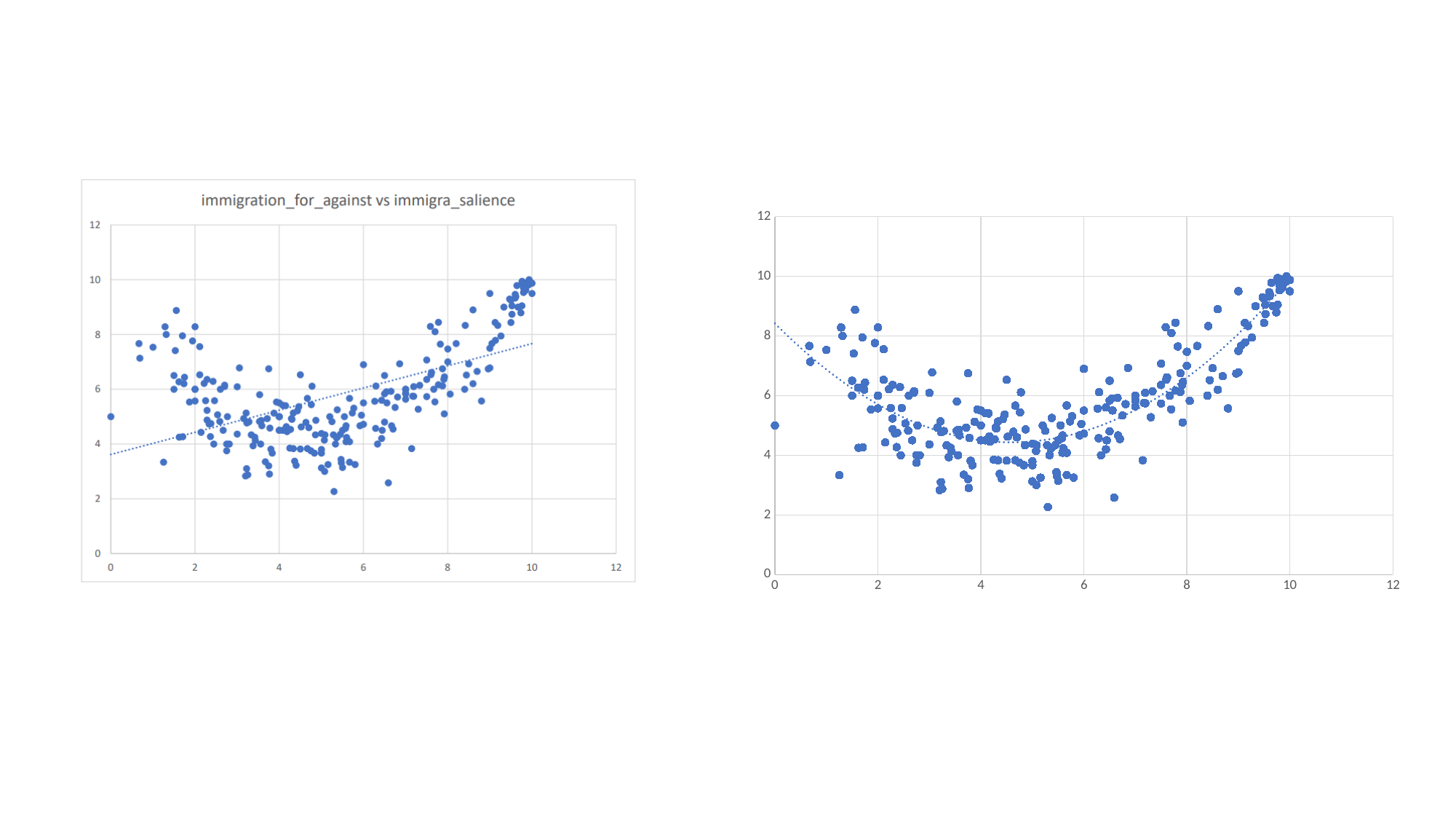
In the left chart, is the trendline's value at x = 0 greater or less than 4? less What is the title of the left chart? immigration_for_against vs immigra_salience In the right chart, is the trendline's value at x = 10 greater or less than 8? greater What is the highest tick value shown on the x axis of the left chart? 12 How many charts are shown on the slide? 2 In the left chart, does the dotted trendline rise or fall as x increases? rise What kind of chart is the right chart on the slide? scatter chart In the right chart, what shape does the dotted trendline follow as x increases? falls then rises (U-shaped curve) What kind of chart is the left chart titled "immigration_for_against vs immigra_salience"? scatter chart In the right chart, is the trendline's value at x = 0 greater or less than 8? greater What is the highest tick value shown on the y axis of the right chart? 12